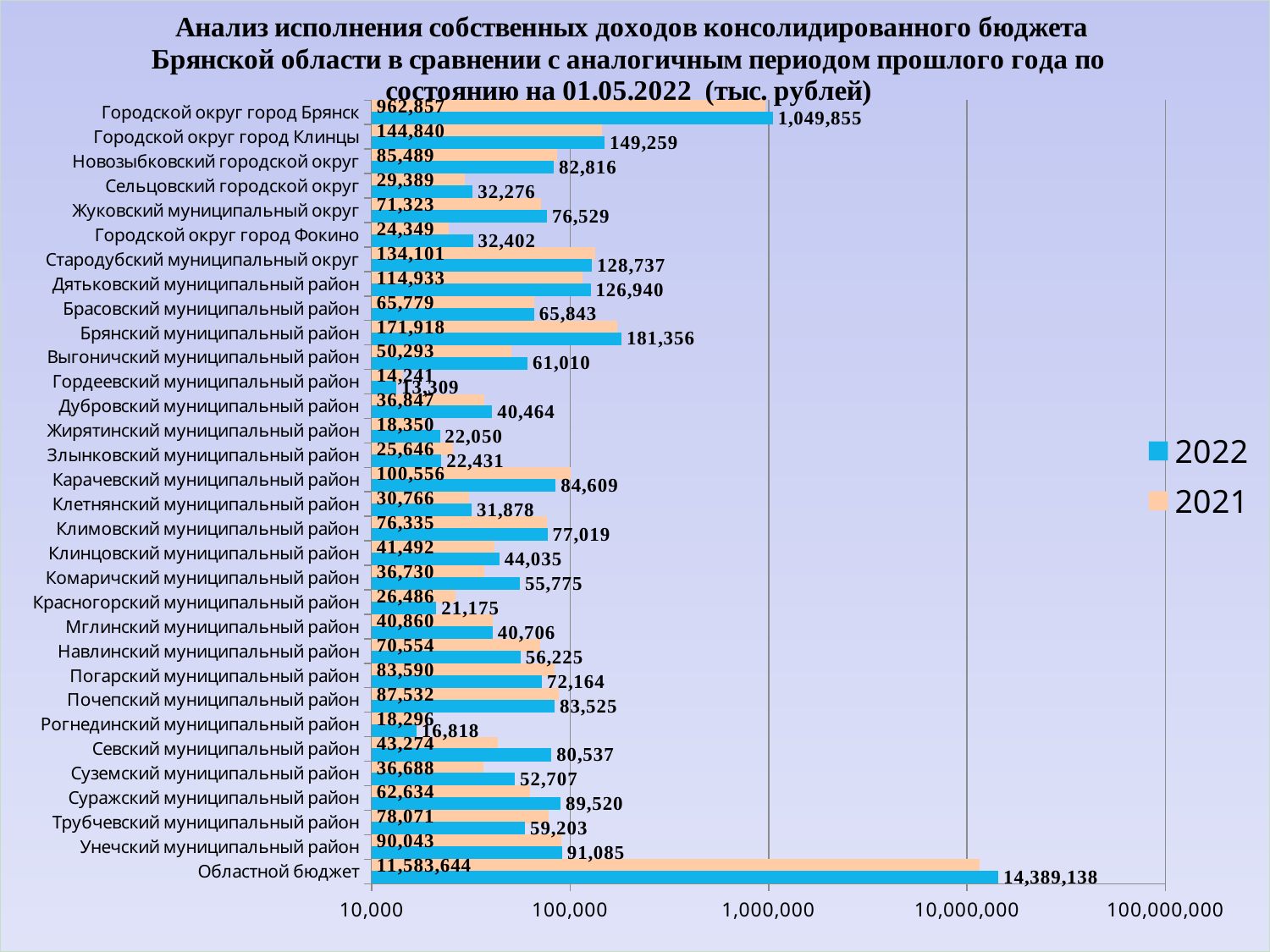
Which category has the highest 2022 value? Областной бюджет What is the 2022 value for Севский муниципальный район? 80,537 What is the 2021 value for Городской округ город Брянск? 962,857 What is the difference between the 2022 and 2021 values for Областной бюджет? 2,805,494 Which category has the lowest 2022 value? Гордеевский муниципальный район What type of chart is shown on the slide? bar chart What is the 2022 value for Областной бюджет? 14,389,138 What is the difference between the 2022 and 2021 values for Городской округ город Брянск? 86,998 Which series is shown in blue in the legend? 2022 How many series does the legend list? 2 Which is larger for Трубчевский муниципальный район, the 2021 value or the 2022 value? 2021 How many categories are plotted on the chart? 32